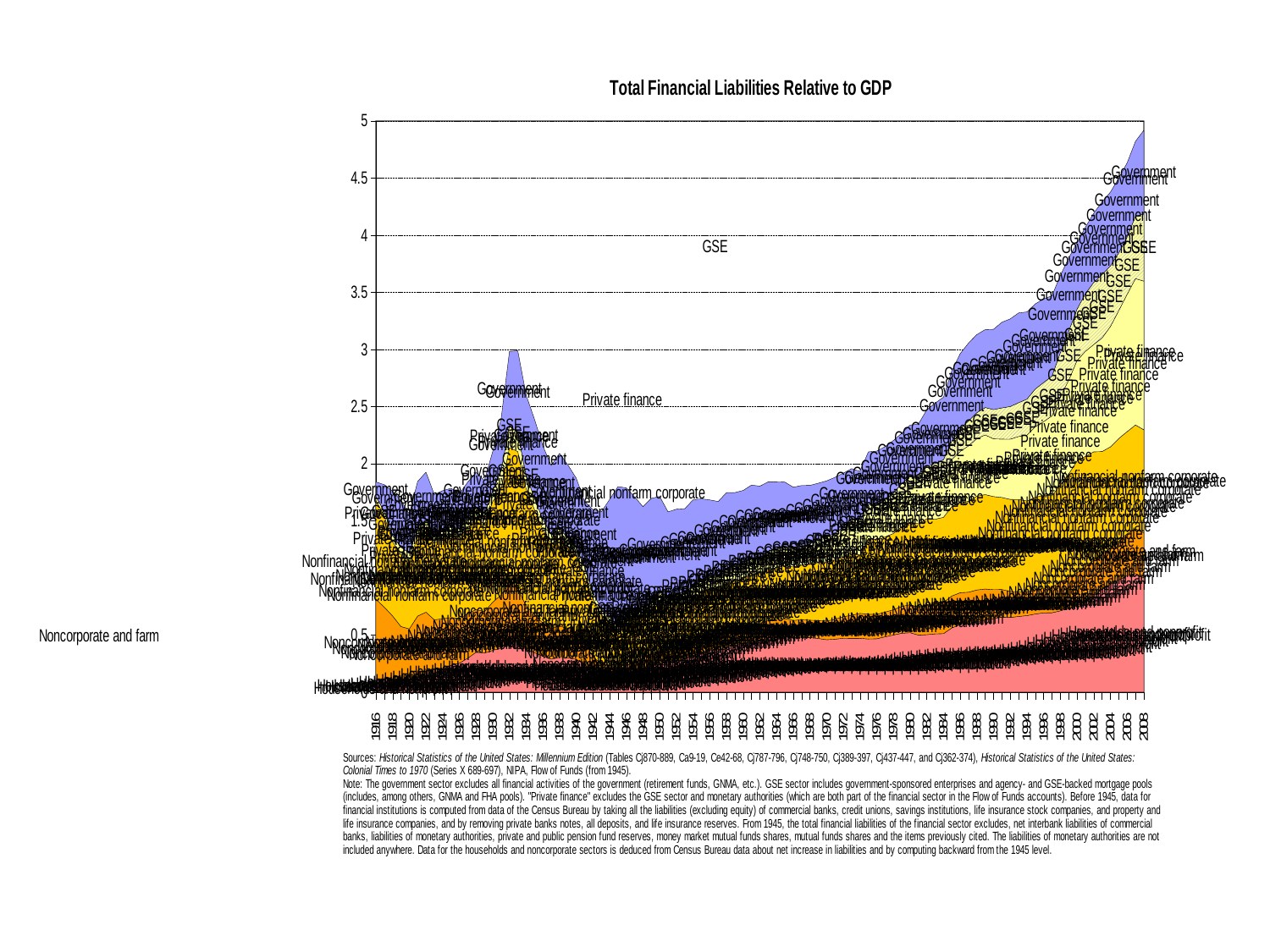
What is the first year shown on the x axis? 1916 Is the total value for 1916 greater or less than 2? less Does the total value rise or fall between 1980 and 2008? rise Which sector forms the top layer of the stacked areas? Government What kind of chart is shown on the slide? Stacked area chart What is the highest value shown on the y axis? 5 What is the last year shown on the x axis? 2008 Is the total value for 2008 greater or less than 4.5? greater Which is larger, the total value for 2008 or the total value for 1946? 2008 Is the total value for 1950 greater or less than 2? less What is the title of the chart? Total Financial Liabilities Relative to GDP